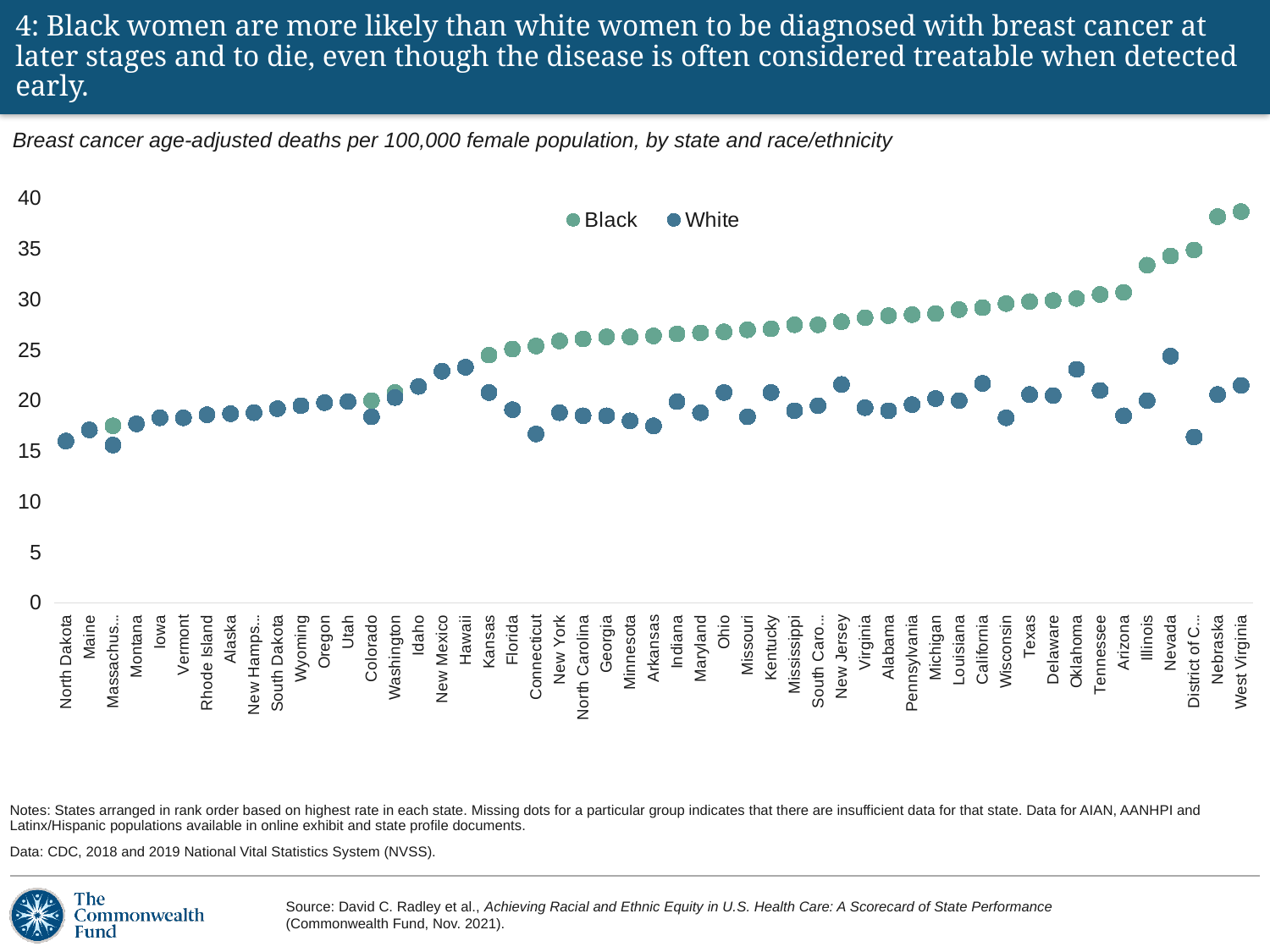
Do the Black values generally rise or fall moving left to right along the x axis? rise What kind of chart is shown on the slide? Dot (scatter) chart How many states (categories) are shown on the x axis? 51 How many series does the legend list? 2 Is the Black value for Illinois greater or less than 30? greater Is the White value for Connecticut greater or less than 20? less Is the White value for Nevada greater or less than 20? greater Which state has the lowest Black value? Massachusetts Which colour represents the White series in the legend? Dark blue Which is larger for West Virginia, the Black value or the White value? Black